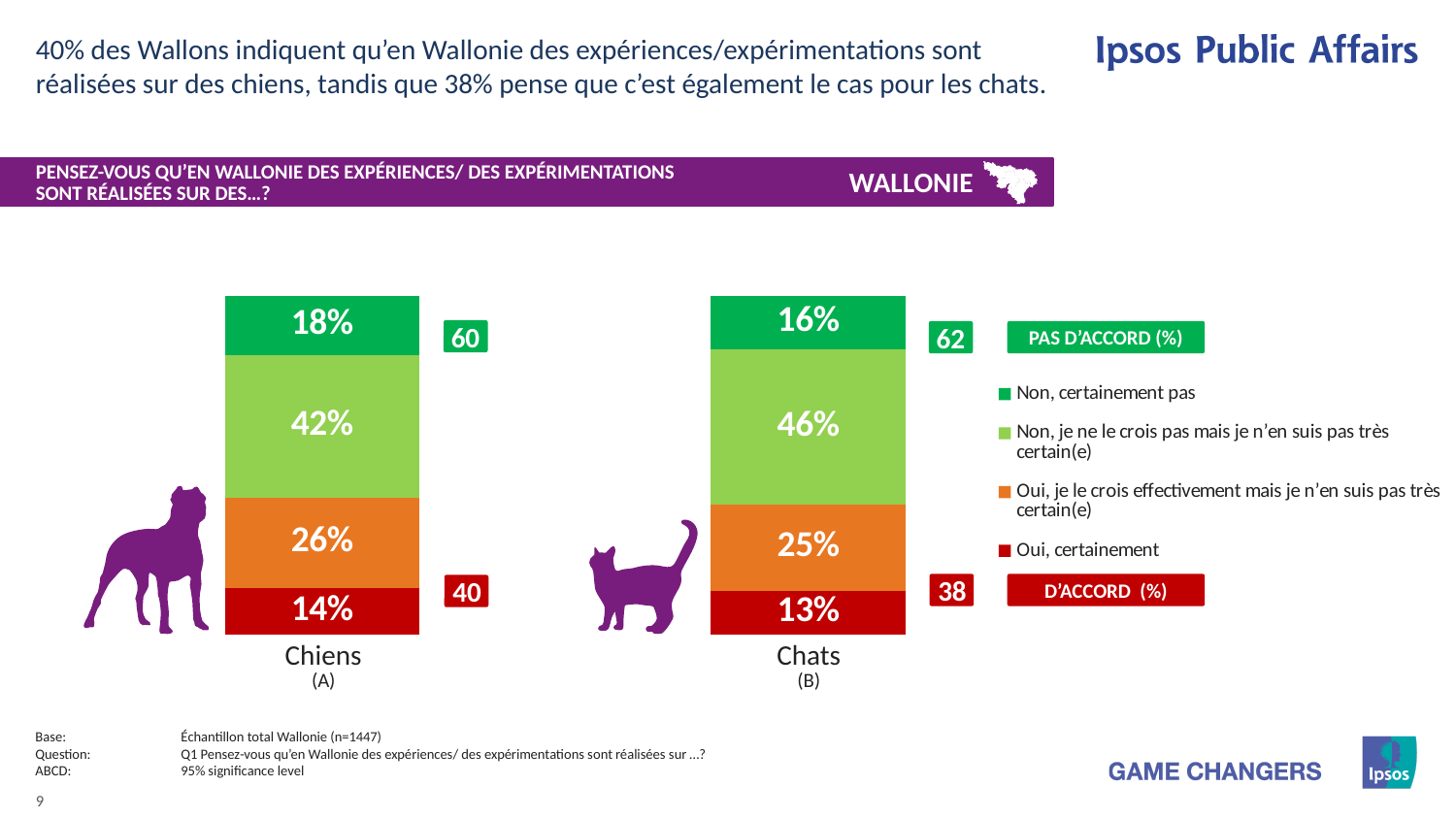
Which segment is the largest within the Chiens bar? Non, je ne le crois pas mais je n'en suis pas très certain(e) What percentage of respondents answered "Oui, certainement" for Chiens? 14% What is the value of the "Oui, je le crois effectivement mais je n'en suis pas très certain(e)" segment for Chiens? 26% What is the total "D'accord (%)" value shown for Chiens? 40 How many series does the legend list? 4 How many categories are shown on the x axis of the chart? 2 What percentage of respondents answered "Non, certainement pas" for Chats? 16% Which segment is the smallest within the Chats bar? Oui, certainement Which category has the larger "Oui, certainement" value, Chiens or Chats? Chiens What is the total "Pas d'accord (%)" value shown for Chats? 62 What is the value of the "Non, je ne le crois pas mais je n'en suis pas très certain(e)" segment for Chats? 46% What is the difference between the "Non, je ne le crois pas mais je n'en suis pas très certain(e)" values for Chats and Chiens? 4 percentage points